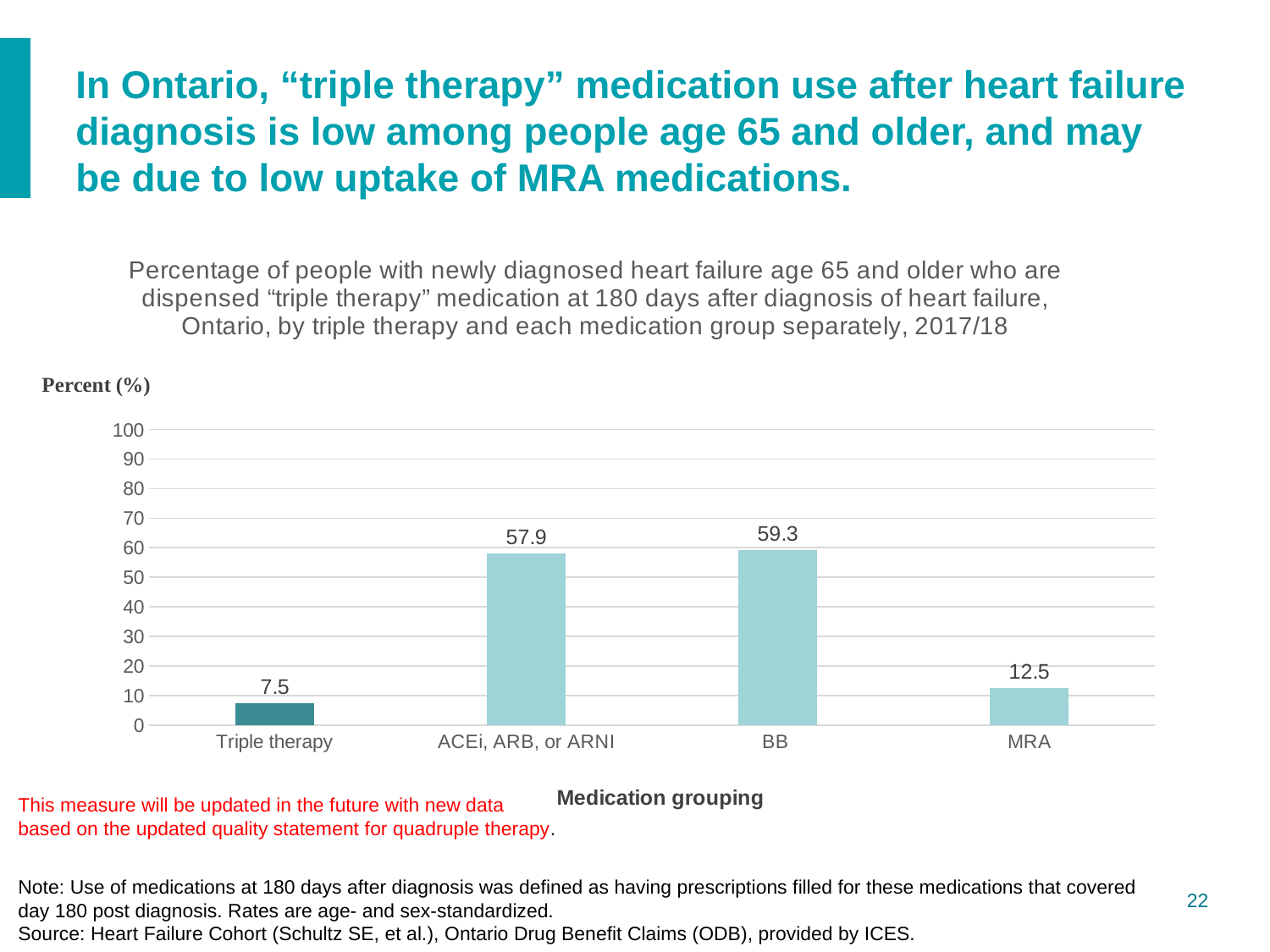
What is the value for MRA? 12.5 What is the difference between the values for MRA and Triple therapy? 5.0 Which medication grouping has the highest value? BB What is the label of the x axis? Medication grouping What is the value for ACEi, ARB, or ARNI? 57.9 Which medication grouping has the lowest value? Triple therapy What kind of chart is shown on the slide? Bar chart How many medication groupings are shown on the x axis? 4 Which is larger, the value for ACEi, ARB, or ARNI or the value for MRA? ACEi, ARB, or ARNI What is the value for Triple therapy? 7.5 What is the value for BB? 59.3 What is the difference between the values for BB and MRA? 46.8